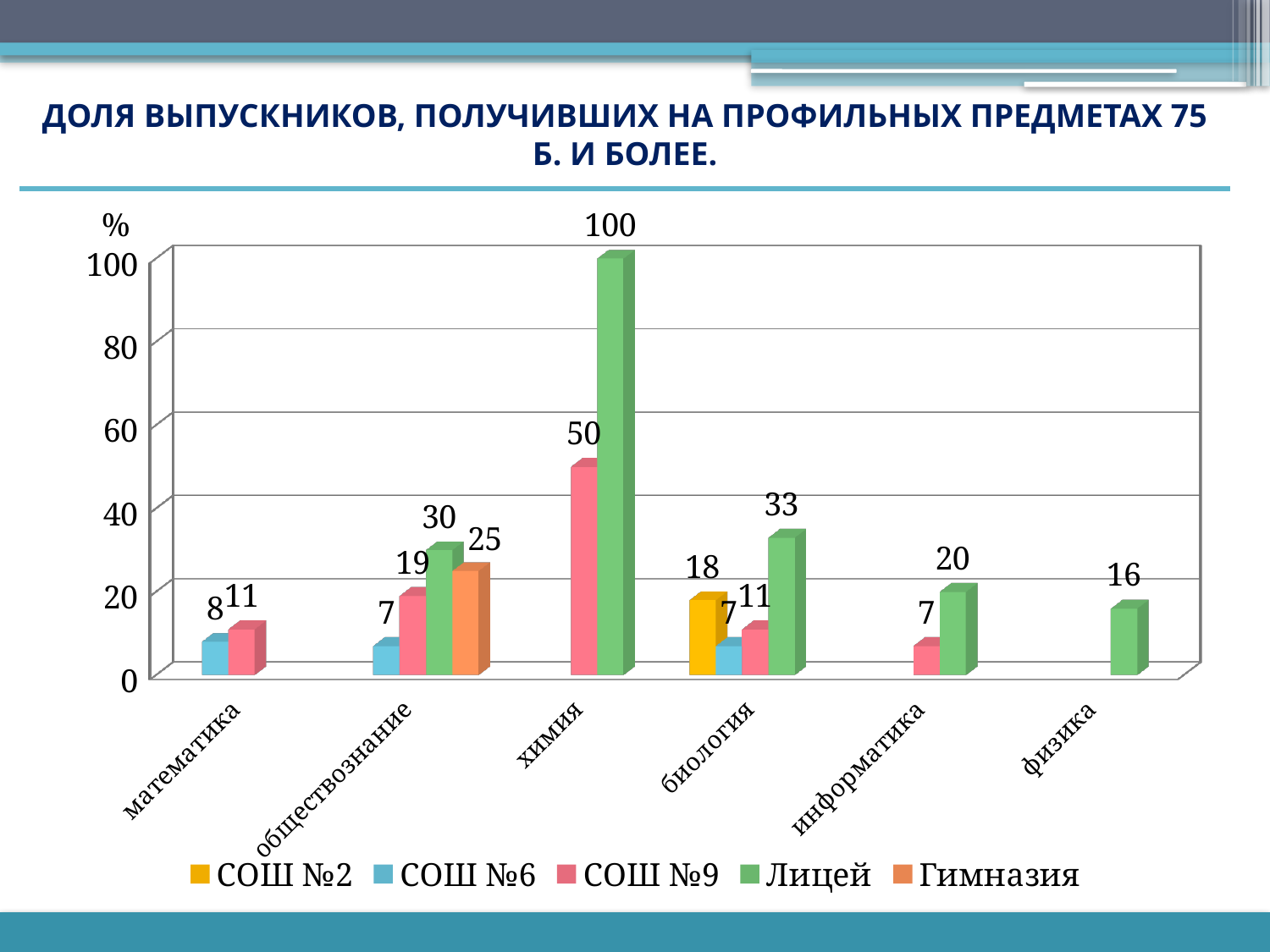
Which category has the highest value for Лицей? химия Which category has the lowest value for Лицей? физика Which is larger in биология: СОШ №2 or СОШ №9? СОШ №2 What is the value for Лицей in химия? 100 How many series does the legend list? 5 What is the value for СОШ №2 in биология? 18 What kind of chart is shown on the slide? bar chart What is the value for СОШ №9 in обществознание? 19 Which series is shown in green in the legend? Лицей What is the difference between Лицей and СОШ №9 in химия? 50 How many categories are shown on the x axis? 6 What is the value for Гимназия in обществознание? 25